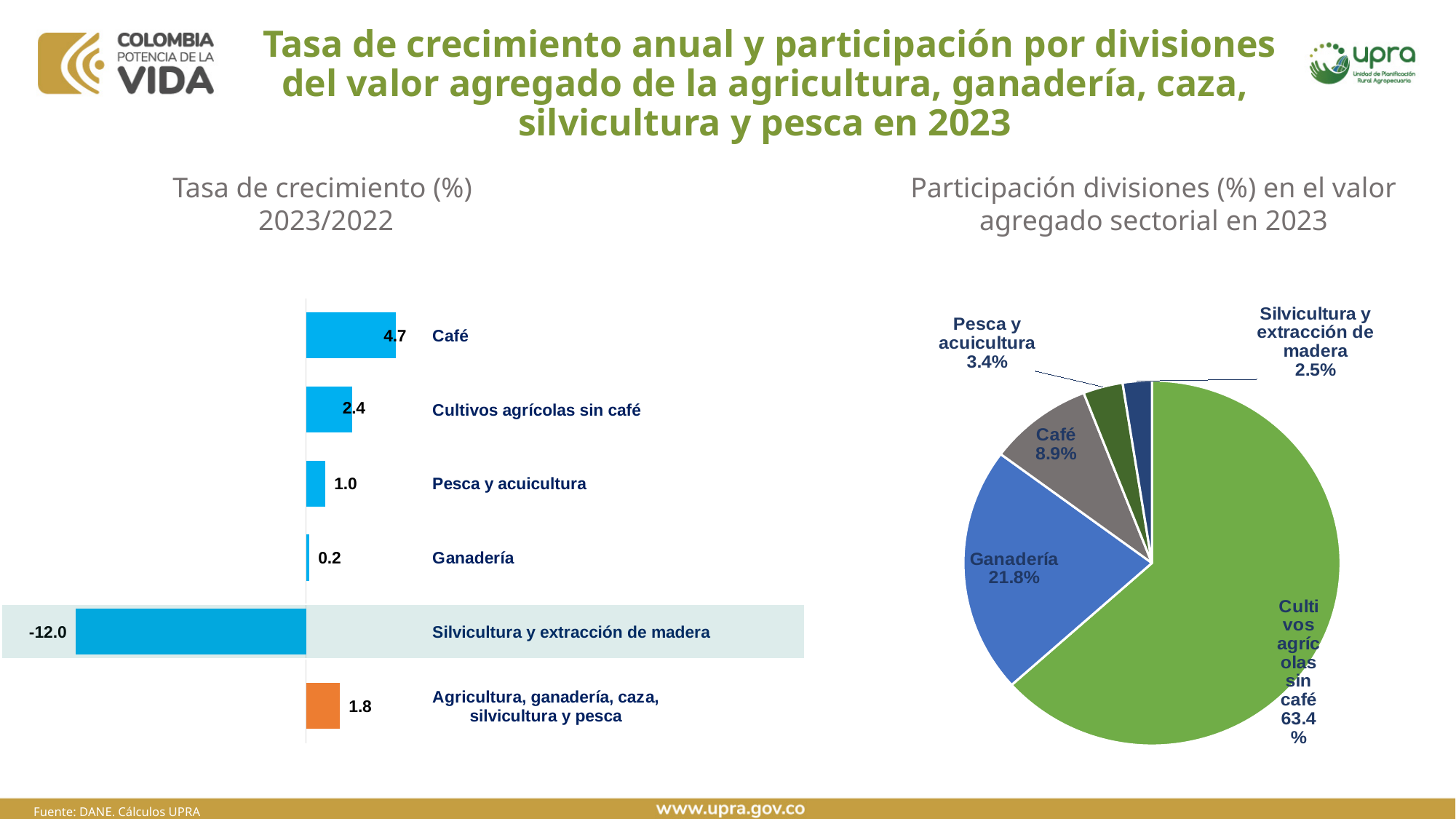
What kind of chart is the 'Tasa de crecimiento (%) 2023/2022' chart? Bar chart What kind of chart is the 'Participación divisiones (%) en el valor agregado sectorial en 2023' chart? Pie chart In the 'Tasa de crecimiento (%) 2023/2022' chart, what is the difference between the growth rates of Café and Cultivos agrícolas sin café? 2.3 In the 'Participación divisiones (%) en el valor agregado sectorial en 2023' chart, what share does Ganadería have? 21.8% In the 'Tasa de crecimiento (%) 2023/2022' chart, which category has the highest growth rate? Café How many categories are shown in the 'Tasa de crecimiento (%) 2023/2022' chart? 6 In the 'Tasa de crecimiento (%) 2023/2022' chart, what is the growth rate for Silvicultura y extracción de madera? -12.0 In the 'Participación divisiones (%) en el valor agregado sectorial en 2023' chart, which division has the largest share? Cultivos agrícolas sin café In the 'Tasa de crecimiento (%) 2023/2022' chart, what is the growth rate for Café? 4.7 In the 'Participación divisiones (%) en el valor agregado sectorial en 2023' chart, which division has the smallest share? Silvicultura y extracción de madera In the 'Tasa de crecimiento (%) 2023/2022' chart, which is larger: the growth rate for Pesca y acuicultura or for Ganadería? Pesca y acuicultura In the 'Tasa de crecimiento (%) 2023/2022' chart, which category has the lowest growth rate? Silvicultura y extracción de madera